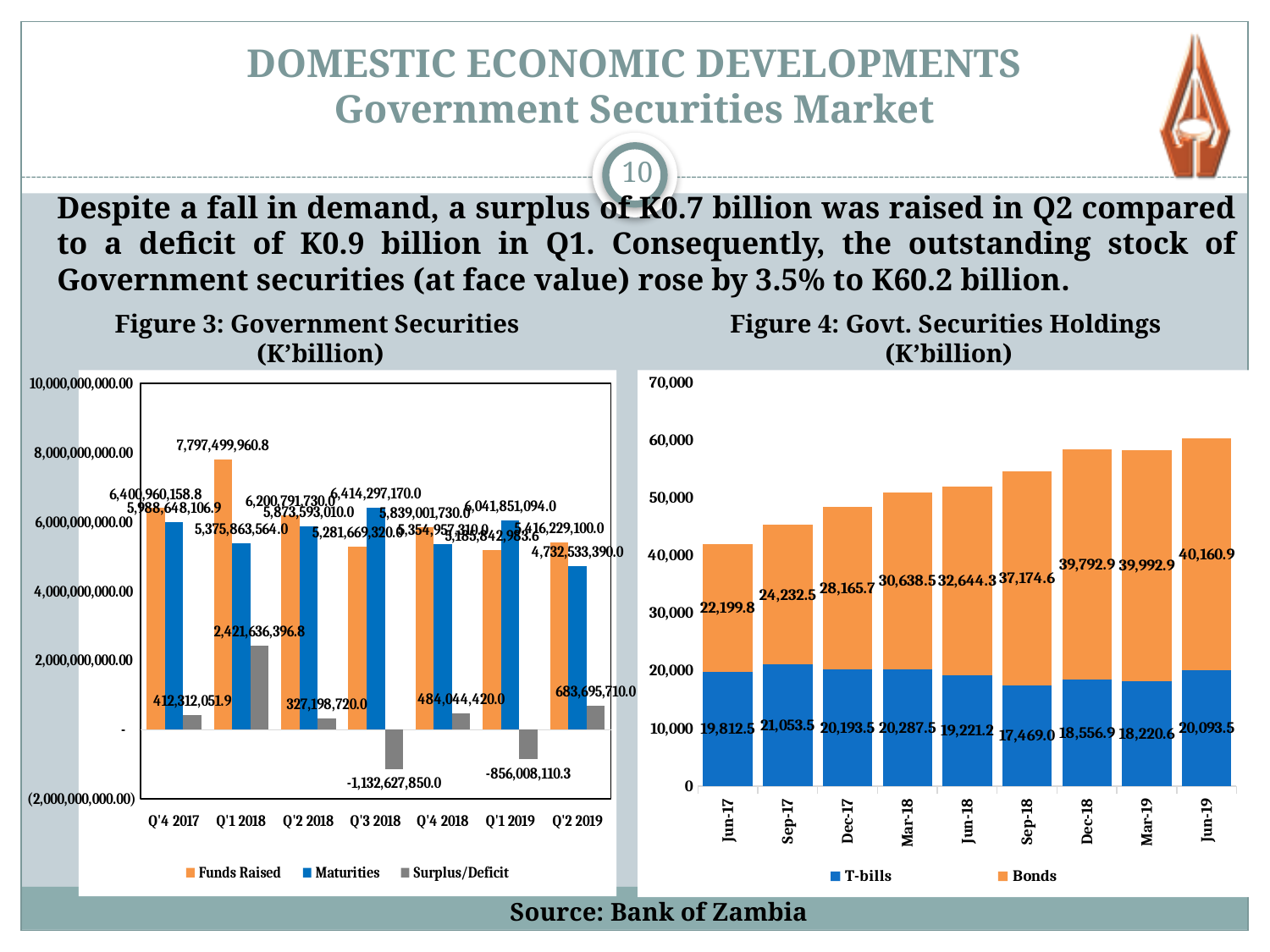
In Figure 4: Govt. Securities Holdings, what is the total of the stacked bar for Jun-19? 60,254.4 In Figure 3: Government Securities, what is the Surplus/Deficit value for Q'3 2018? -1,132,627,850.0 In Figure 4: Govt. Securities Holdings, what is the Bonds value for Jun-19? 40,160.9 In Figure 4: Govt. Securities Holdings, do the Bonds values rise or fall from Jun-17 to Jun-19? rise In Figure 4: Govt. Securities Holdings, which period has the highest T-bills value? Sep-17 In Figure 3: Government Securities, what is the Funds Raised value for Q'1 2018? 7,797,499,960.8 In Figure 3: Government Securities, how many series does the legend list? 3 In Figure 3: Government Securities, which quarter has the highest Surplus/Deficit value? Q'1 2018 In Figure 4: Govt. Securities Holdings, what is the T-bills value for Sep-18? 17,469.0 In Figure 3: Government Securities, which quarter has the lowest Surplus/Deficit value? Q'3 2018 What kind of chart is Figure 4: Govt. Securities Holdings? stacked bar chart In Figure 3: Government Securities, how many quarters are shown on the x axis? 7